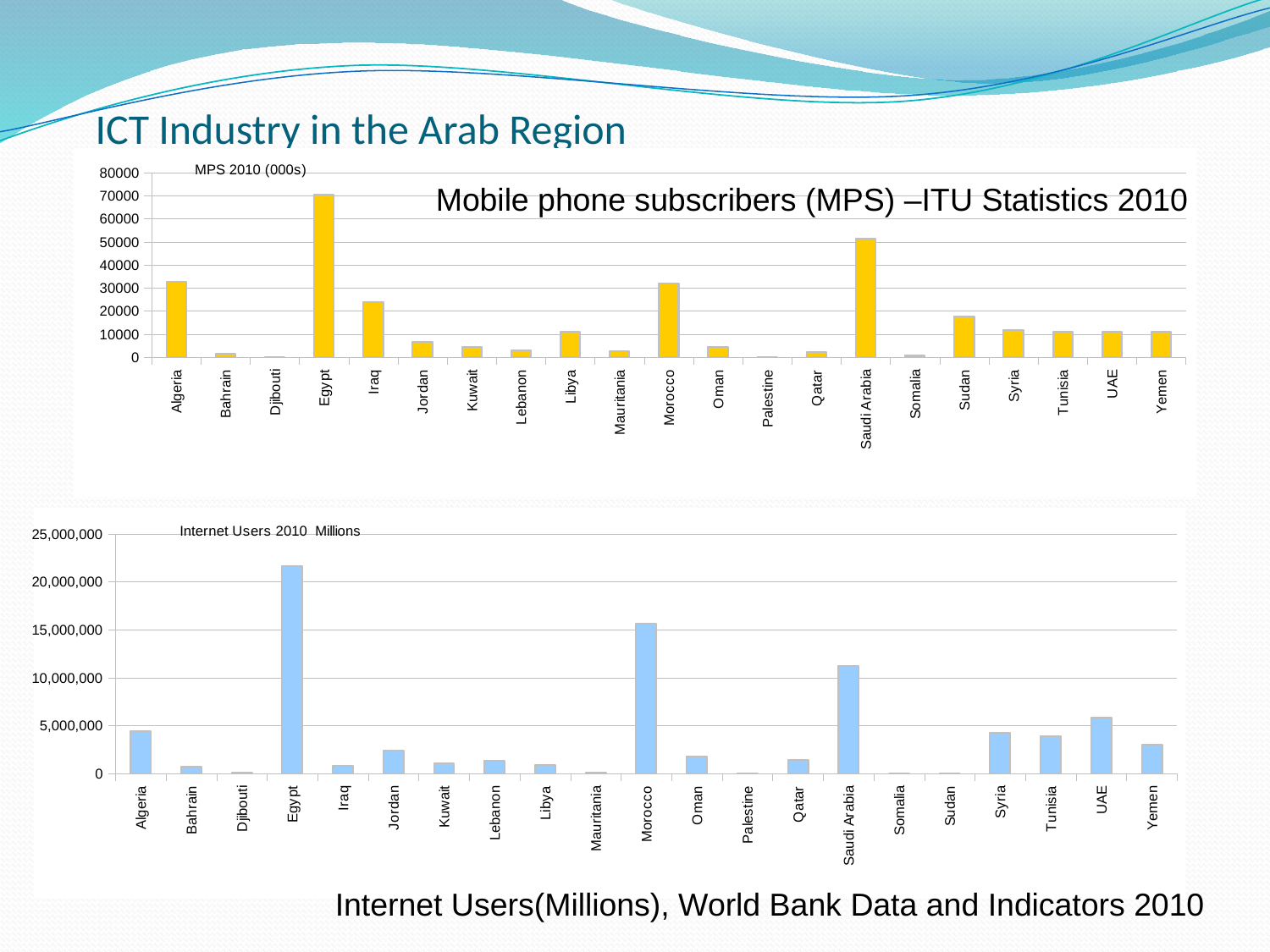
In the top chart (MPS 2010), is the value for Jordan greater or less than 10000? less In the top chart (MPS 2010), which is larger, the value for Iraq or the value for Sudan? Iraq What is the title shown on the top chart? MPS 2010 (000s) In the bottom chart (Internet Users 2010), is the value for Algeria greater or less than 5,000,000? less In the top chart (MPS 2010), is the value for Saudi Arabia greater or less than 40000? greater In the top chart (MPS 2010), which country has the highest number of mobile phone subscribers? Egypt In the bottom chart (Internet Users 2010), which country has the highest number of internet users? Egypt In the bottom chart (Internet Users 2010), which is larger, the value for Morocco or the value for Saudi Arabia? Morocco How many countries are shown on the x axis of the top chart (MPS 2010)? 21 What kind of chart is the bottom chart (Internet Users 2010)? Bar chart